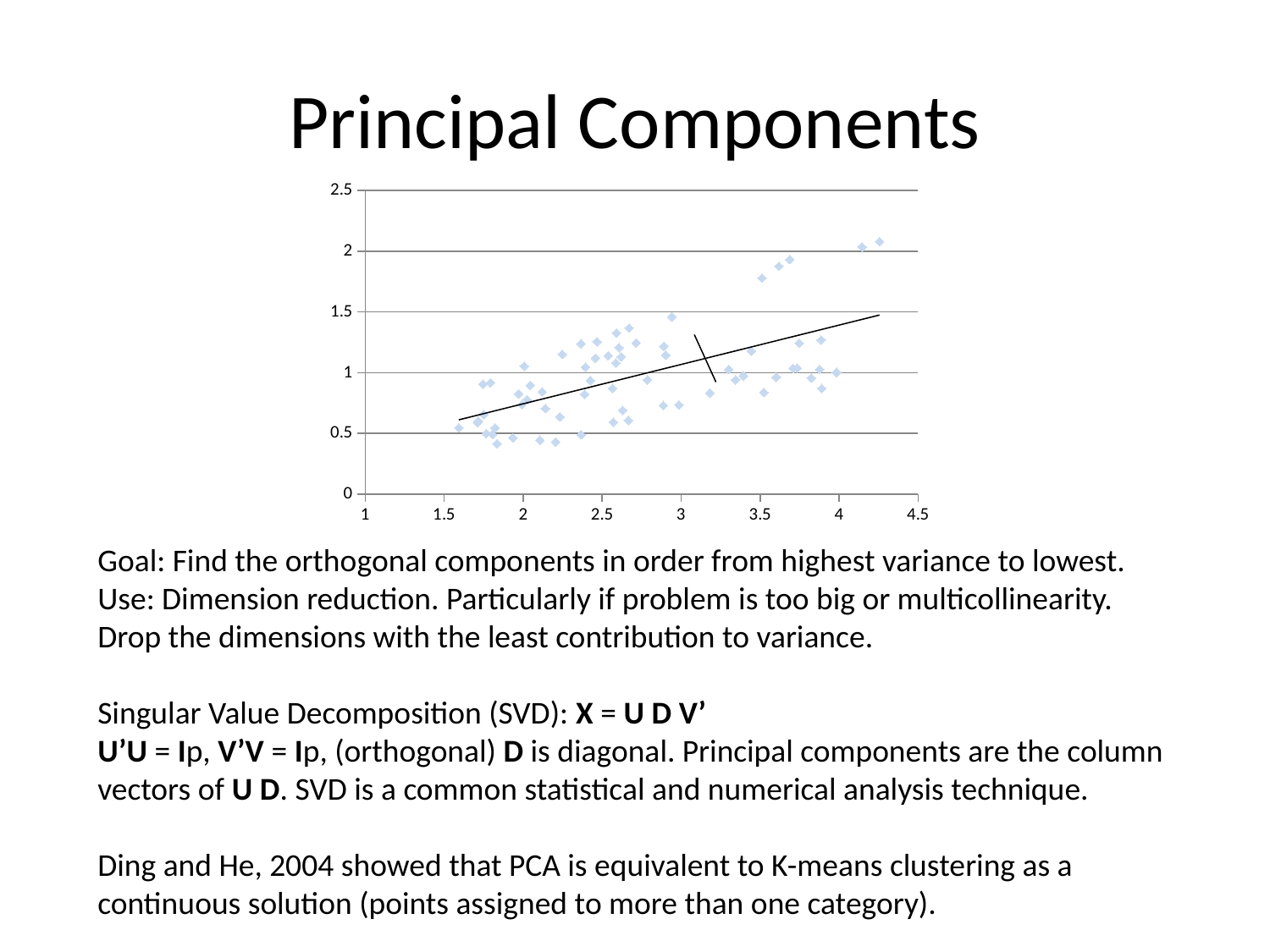
What kind of chart is shown on the slide? scatter chart Is the y value of the lowest plotted point greater or less than 0.5? less Is the x value of the rightmost plotted point greater or less than 4? greater Are any plotted points above the y value of 2.5? no What is the highest value shown on the y axis of the chart? 2.5 What is the spacing between consecutive tick labels on the x axis? 0.5 Do the plotted points generally rise or fall as the x value increases? rise What is the highest value shown on the x axis of the chart? 4.5